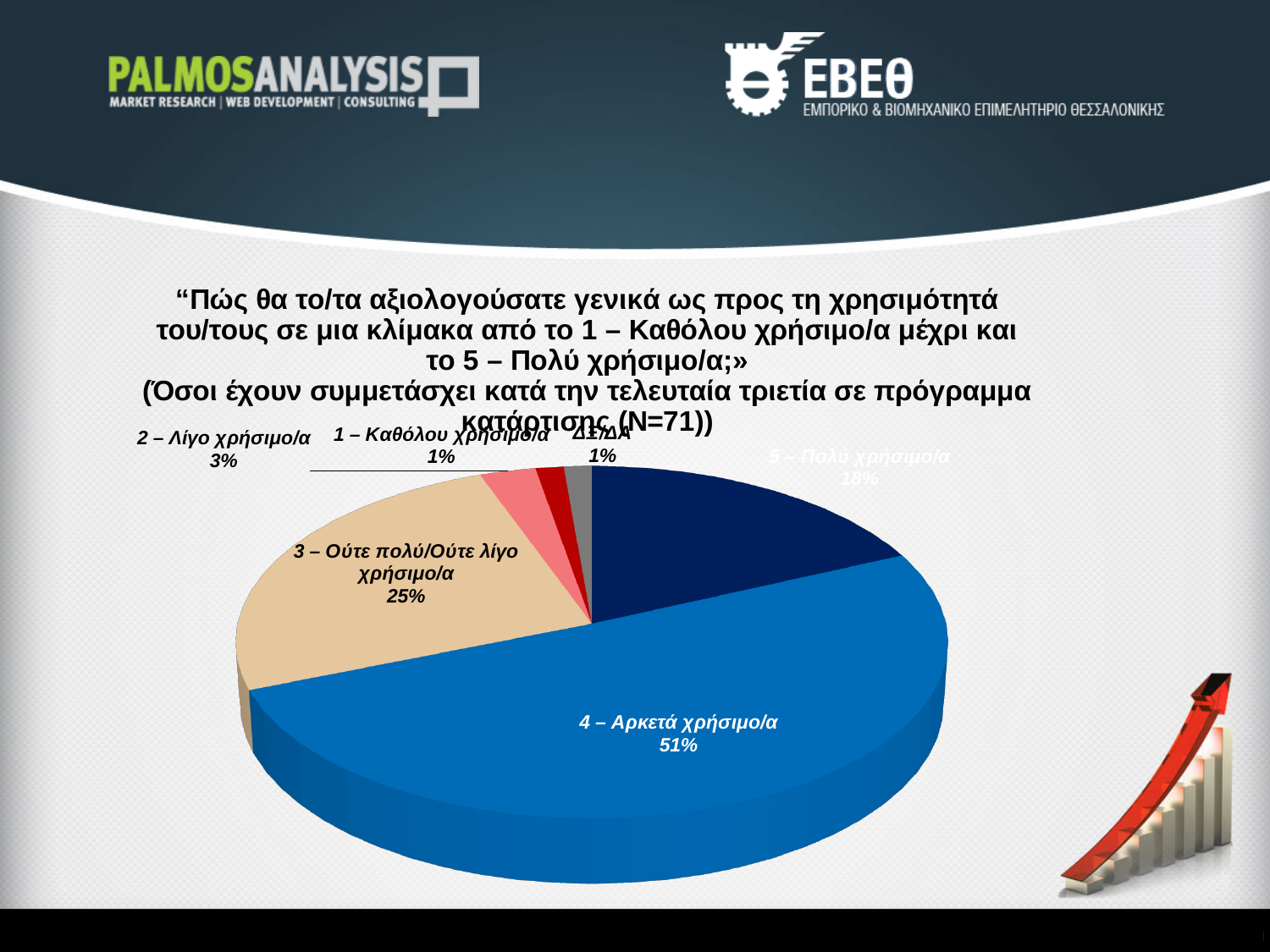
What percentage is shown for "2 – Λίγο χρήσιμο/α"? 3% What percentage is shown for "1 – Καθόλου χρήσιμο/α"? 1% How many slices does the pie chart have? 6 What kind of chart is shown on the slide? Pie chart What percentage is shown for "5 – Πολύ χρήσιμο/α"? 18% What is the difference in percentage points between "4 – Αρκετά χρήσιμο/α" and "3 – Ούτε πολύ/Ούτε λίγο χρήσιμο/α"? 26 Which category has the largest slice of the pie? 4 – Αρκετά χρήσιμο/α What share of the pie does "4 – Αρκετά χρήσιμο/α" hold? 51% What is the sample size (N) stated in the chart title? N=71 What is the difference in percentage points between "5 – Πολύ χρήσιμο/α" and "2 – Λίγο χρήσιμο/α"? 15 Which is larger, the slice for "5 – Πολύ χρήσιμο/α" or the slice for "3 – Ούτε πολύ/Ούτε λίγο χρήσιμο/α"? 3 – Ούτε πολύ/Ούτε λίγο χρήσιμο/α What percentage is shown for "3 – Ούτε πολύ/Ούτε λίγο χρήσιμο/α"? 25%